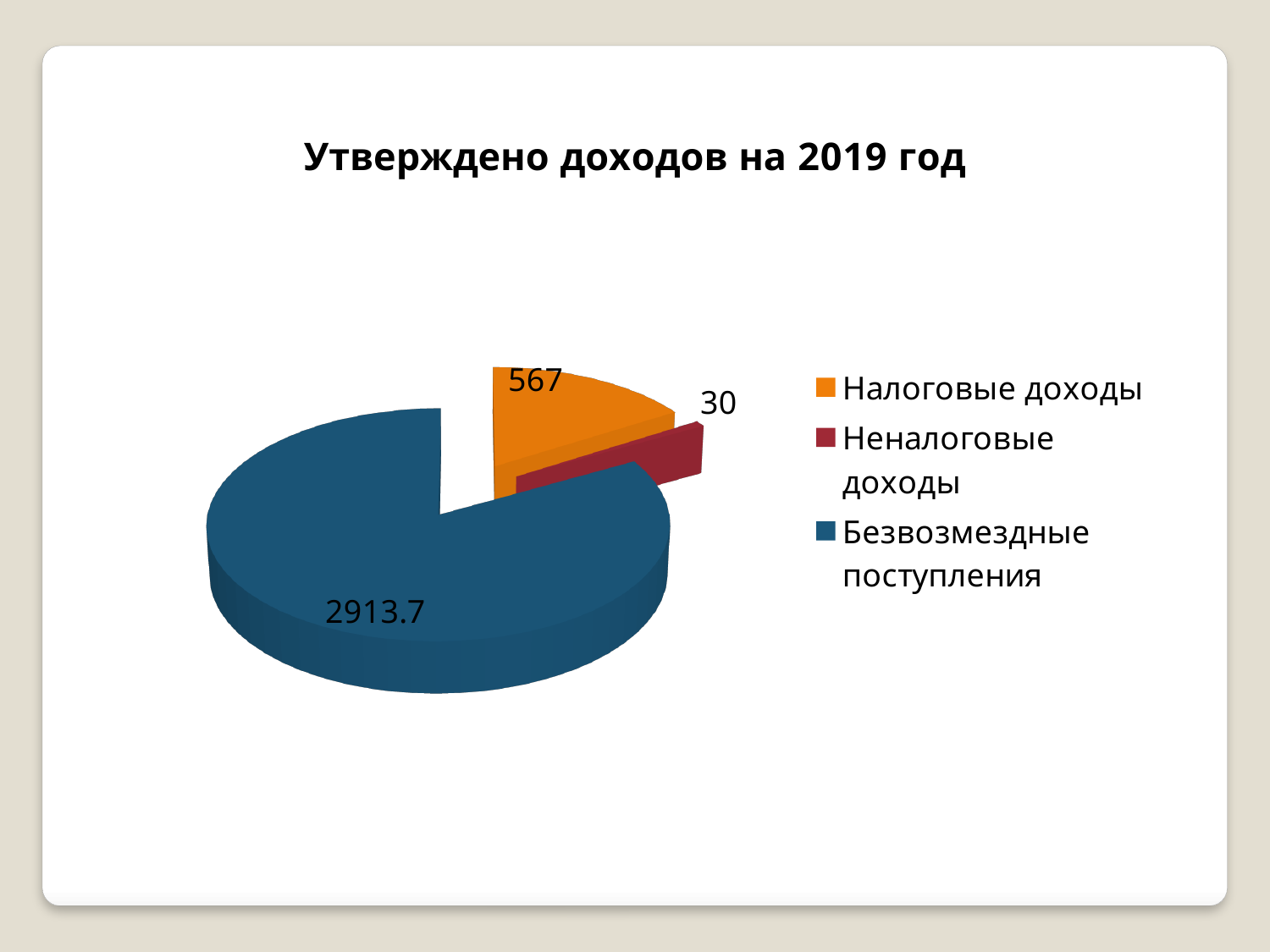
What is the value for Безвозмездные поступления? 2913.7 What is the value for Налоговые доходы? 567 Which is larger, Налоговые доходы or Неналоговые доходы? Налоговые доходы Which category has the smallest slice of the pie? Неналоговые доходы What is the title of the chart? Утверждено доходов на 2019 год What is the value for Неналоговые доходы? 30 What is the difference between the values for Безвозмездные поступления and Налоговые доходы? 2346.7 What kind of chart is shown on the slide? Pie chart How many categories does the pie chart show? 3 What is the difference between the values for Налоговые доходы and Неналоговые доходы? 537 What is the total of all slices in the pie chart? 3510.7 Which category has the largest slice of the pie? Безвозмездные поступления